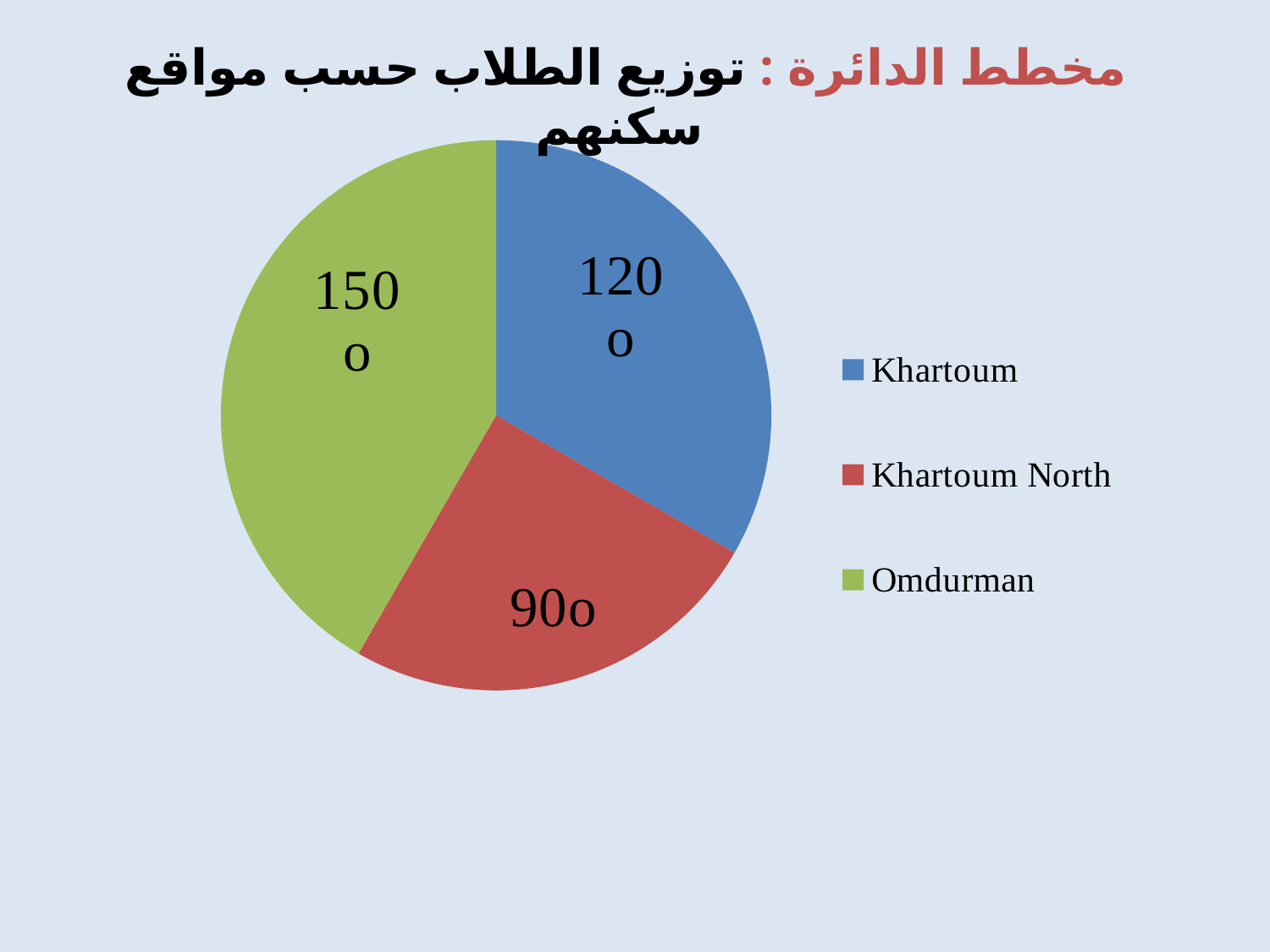
What value is shown on the Khartoum slice of the pie chart? 120o What kind of chart is shown on the slide? Pie chart Which category has the smallest slice of the pie chart? Khartoum North What is the difference between the Omdurman value and the Khartoum North value? 60 What is the difference between the Omdurman value and the Khartoum value? 30 How many entries does the legend list? 3 How many slices does the pie chart have? 3 What value is shown on the Omdurman slice of the pie chart? 150o Which category has the largest slice of the pie chart? Omdurman Which is larger, the Khartoum slice or the Khartoum North slice? Khartoum What colour is the Omdurman slice in the pie chart? Green What value is shown on the Khartoum North slice of the pie chart? 90o